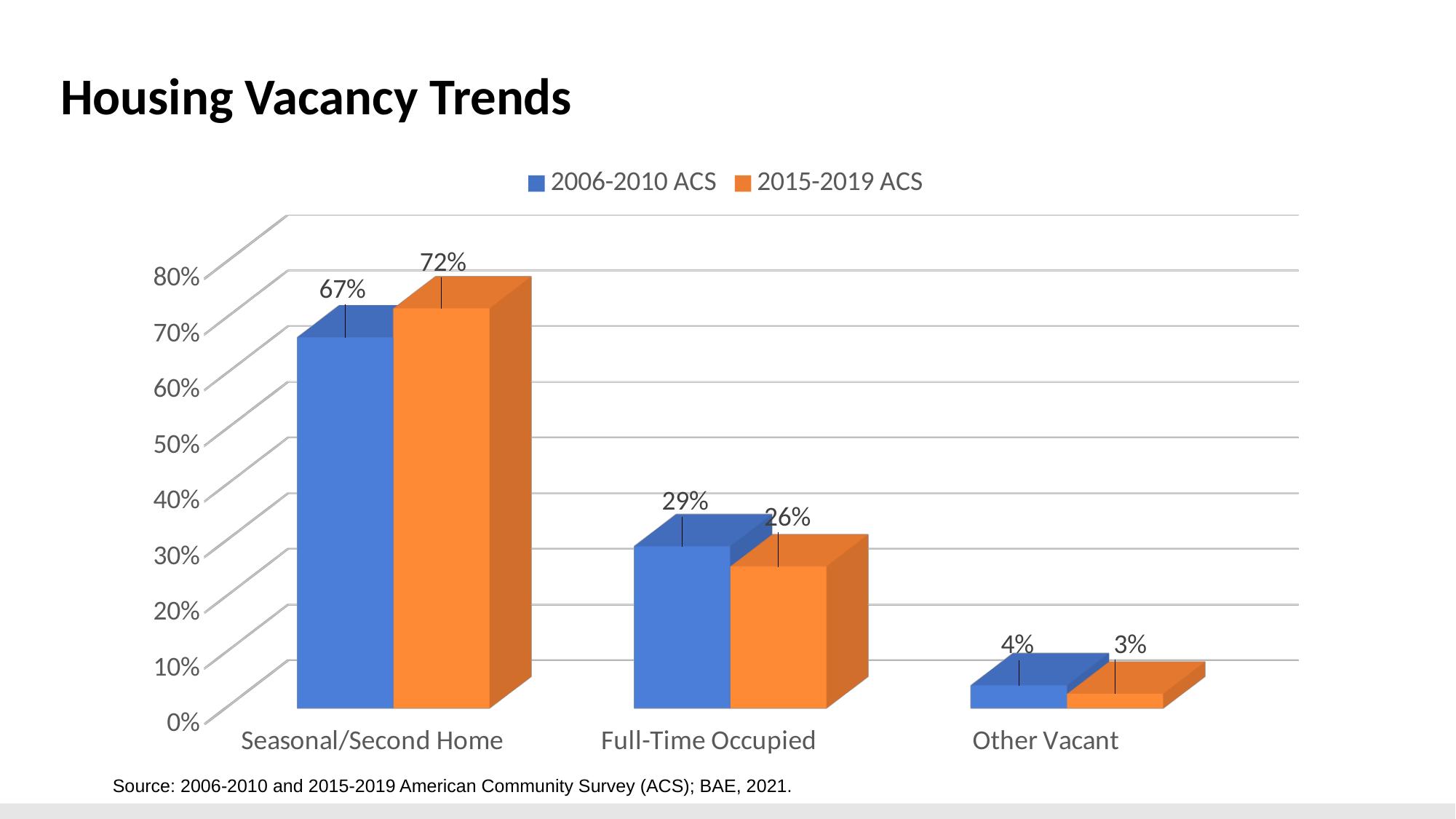
Which category has the highest 2015-2019 ACS value? Seasonal/Second Home How many series does the legend list? 2 What is the title of the slide? Housing Vacancy Trends What kind of chart is shown on the slide? Bar chart For Full-Time Occupied, which series has the larger value, 2006-2010 ACS or 2015-2019 ACS? 2006-2010 ACS How many categories are shown on the x axis? 3 Which category has the lowest 2006-2010 ACS value? Other Vacant What is the difference between the 2006-2010 ACS and 2015-2019 ACS values for Full-Time Occupied? 3% What is the 2006-2010 ACS value for Seasonal/Second Home? 67% What is the 2015-2019 ACS value for Full-Time Occupied? 26% What is the difference between the 2015-2019 ACS and 2006-2010 ACS values for Seasonal/Second Home? 5% What is the 2015-2019 ACS value for Other Vacant? 3%